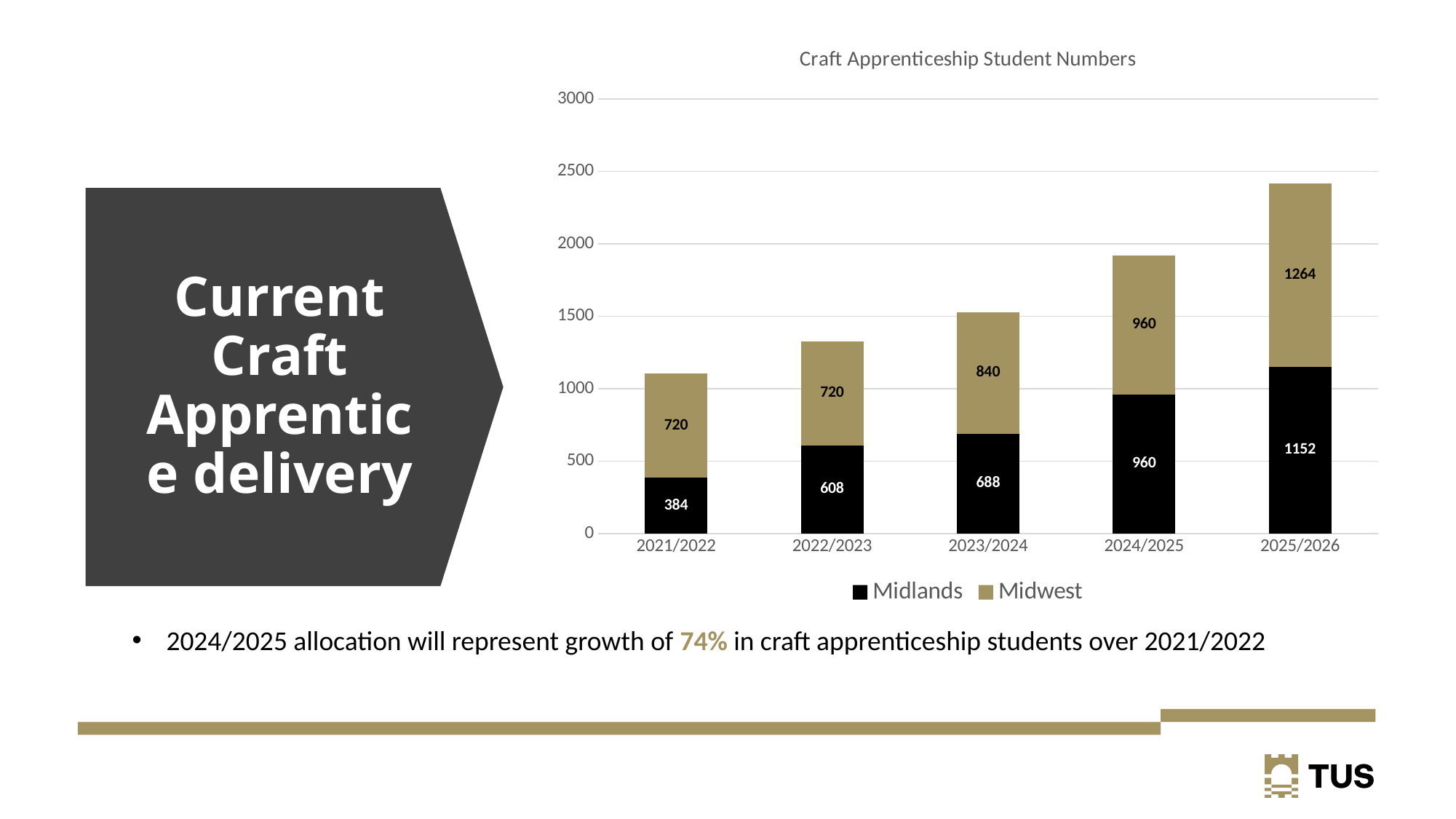
Which is larger, the Midwest value for 2023/2024 or the Midlands value for 2023/2024? Midwest What is the total of the stacked bar for 2021/2022? 1104 What is the Midwest value for 2025/2026? 1264 What is the Midlands value for 2024/2025? 960 How many years are shown on the x axis? 5 What is the total of the stacked bar for 2024/2025? 1920 What is the difference between the Midlands values for 2025/2026 and 2021/2022? 768 What kind of chart is shown? Stacked bar chart Which year has the highest Midlands value? 2025/2026 How many series does the legend list? 2 What is the Midlands value for 2021/2022? 384